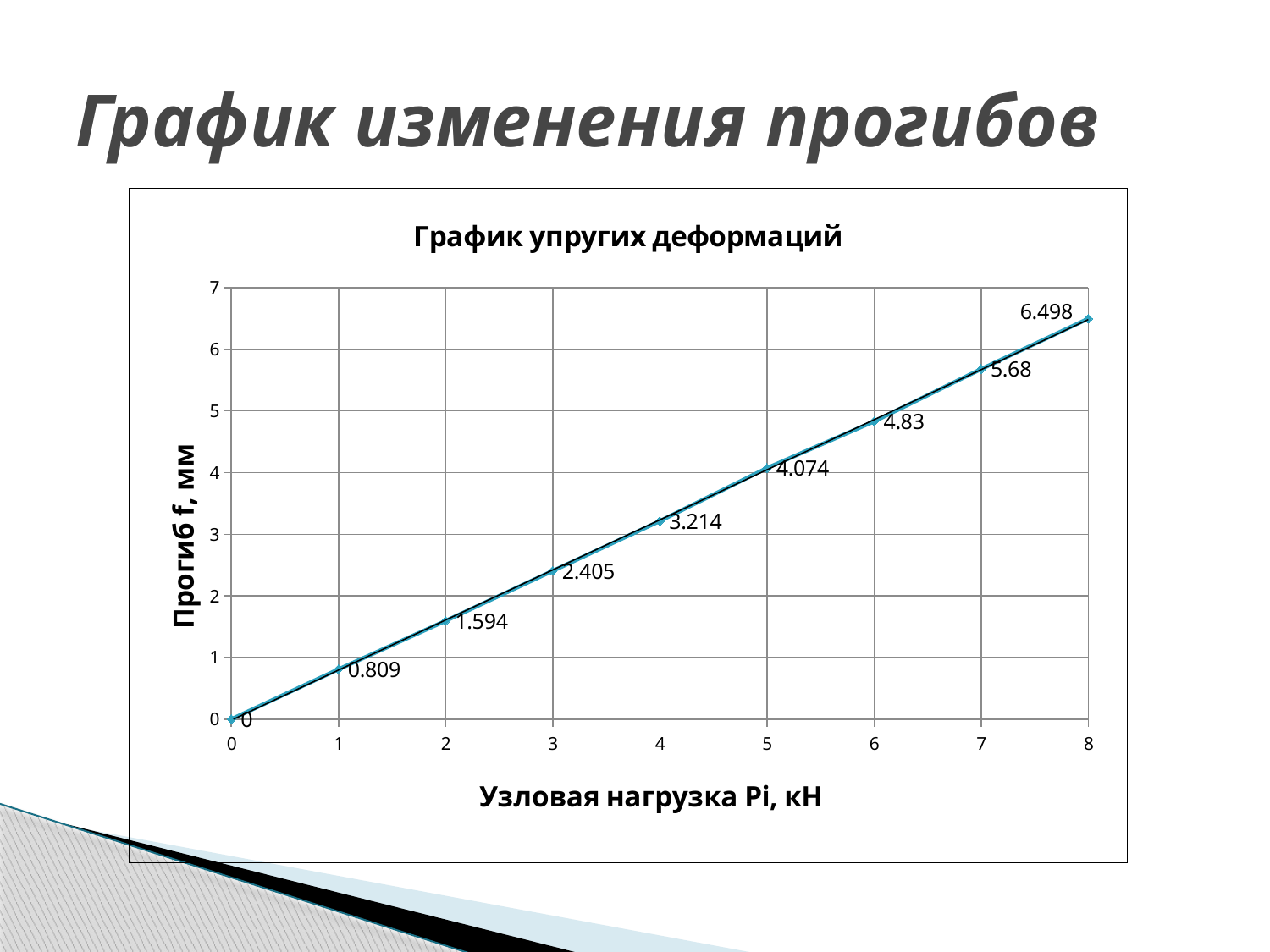
What is the difference between the deflection at 5 kN and the deflection at 4 kN? 0.86 At which nodal load is the deflection lowest? 0 Which is larger: the deflection at 7 kN or the deflection at 2 kN? 7 kN What is the deflection value at a nodal load of 6 kN? 4.83 How many data points are plotted on the chart? 9 Do the deflection values rise or fall as the nodal load increases? Rise What is the deflection value (Прогиб f) at a nodal load of 3 kN? 2.405 What is the deflection value at a nodal load of 8 kN? 6.498 What kind of chart is shown on the slide? Line chart At which nodal load is the deflection highest? 8 What is the title of the chart? График упругих деформаций What is the deflection value at a nodal load of 1 kN? 0.809